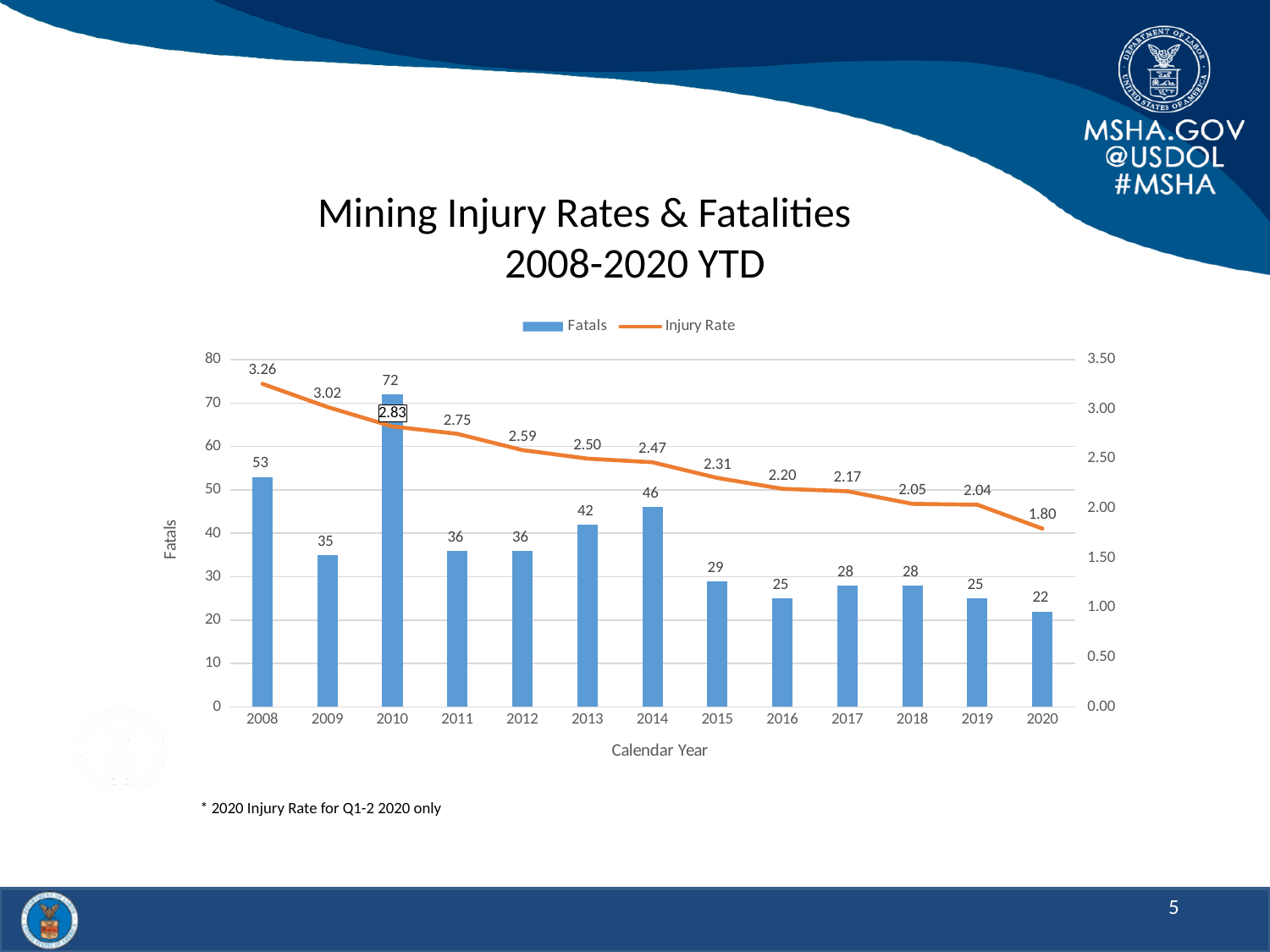
How many fatals were recorded in 2010? 72 Does the injury rate rise or fall from 2008 to 2020? fall How many series does the legend list? 2 What kind of chart is used to show the Fatals series? bar chart What was the injury rate in 2014? 2.47 What is the label of the x axis? Calendar Year Which year had more fatals, 2013 or 2015? 2013 What is the difference in fatals between 2008 and 2009? 18 How many years are shown on the x axis? 13 Which year had the lowest injury rate? 2020 What is the difference between the injury rate in 2008 and in 2020? 1.46 Which year had the highest number of fatals? 2010